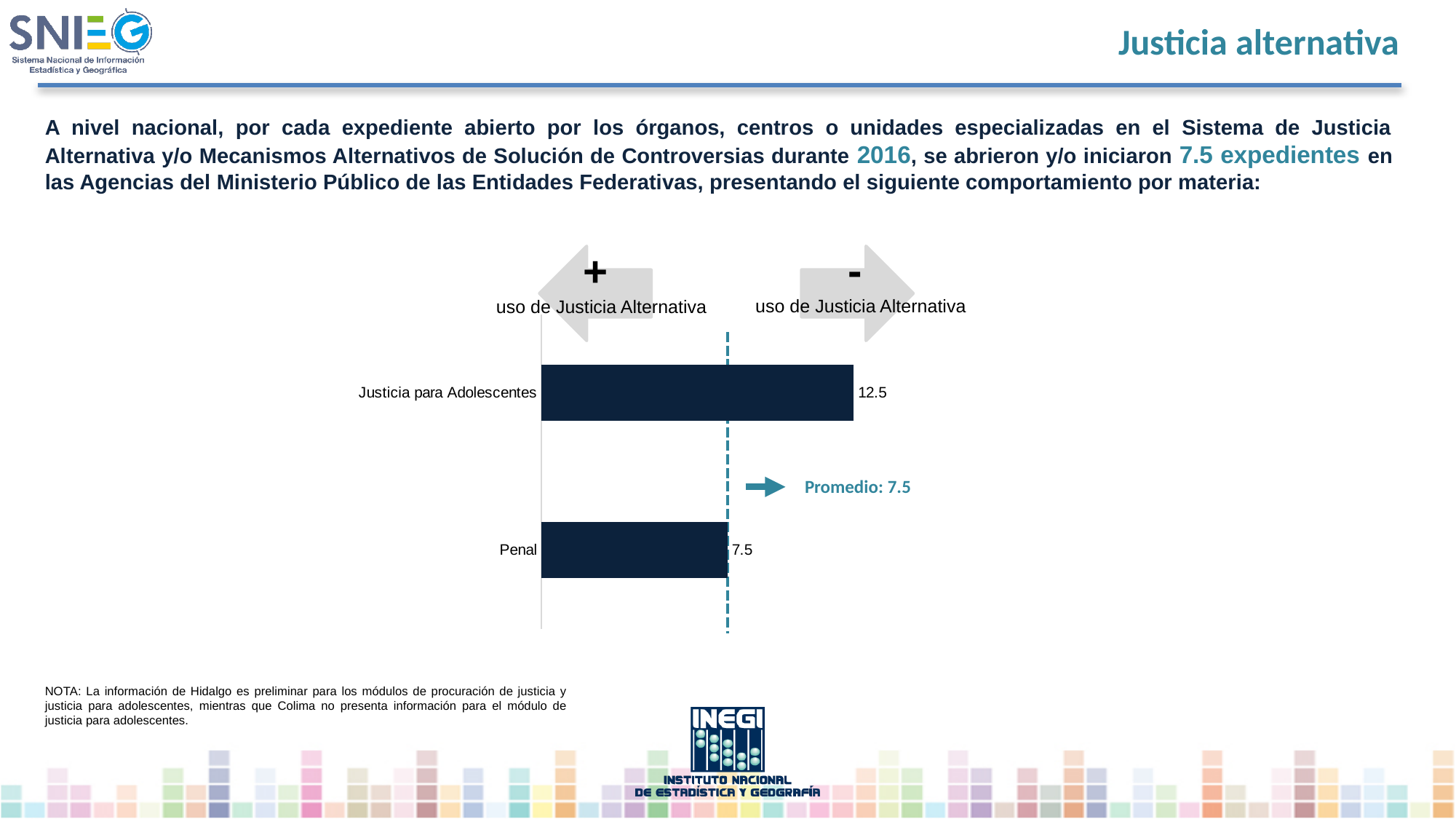
What kind of chart is shown on the slide? Bar chart What is the difference between the values for Justicia para Adolescentes and Penal? 5.0 What is the value for Justicia para Adolescentes? 12.5 Which category has the lowest value? Penal What is the value for Penal? 7.5 Which is larger, the value for Justicia para Adolescentes or the value for Penal? Justicia para Adolescentes How many categories are shown in the chart? 2 What average (Promedio) value is marked by the dashed line in the chart? 7.5 Which category's bar ends exactly at the dashed average line? Penal Which category has the highest value? Justicia para Adolescentes